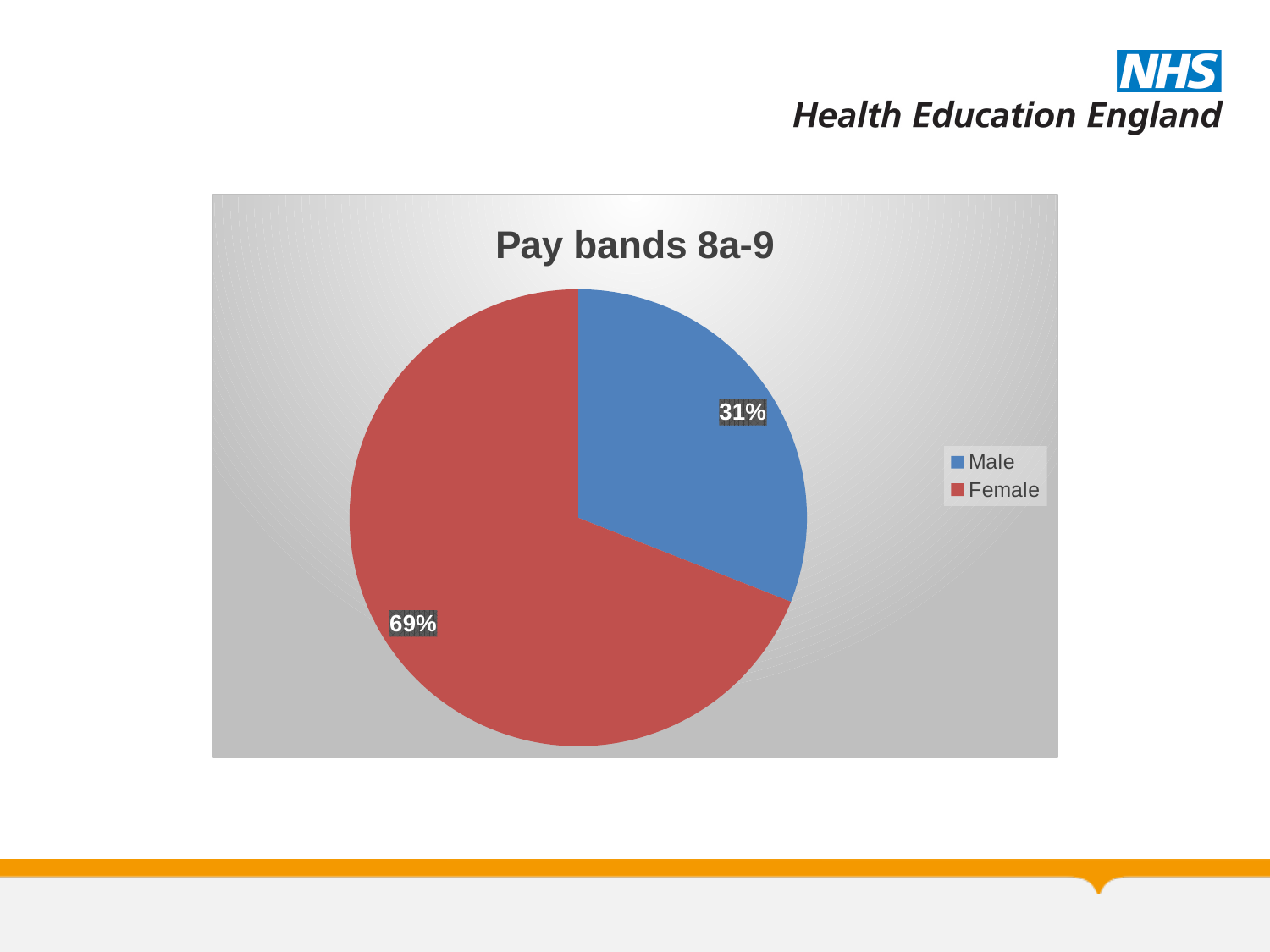
What is the title of the chart? Pay bands 8a-9 What colour represents Female in the chart? Red Which category has the largest share of the pie? Female What percentage of the pie is Female? 69% Which is larger, the Male share or the Female share? Female How many slices does the pie chart have? 2 What is the difference in percentage points between the Female and Male shares? 38 What kind of chart is shown on the slide? Pie chart Is the Male share greater or less than 50%? less How many categories does the legend list? 2 Which category has the smallest share of the pie? Male What percentage of the pie is Male? 31%